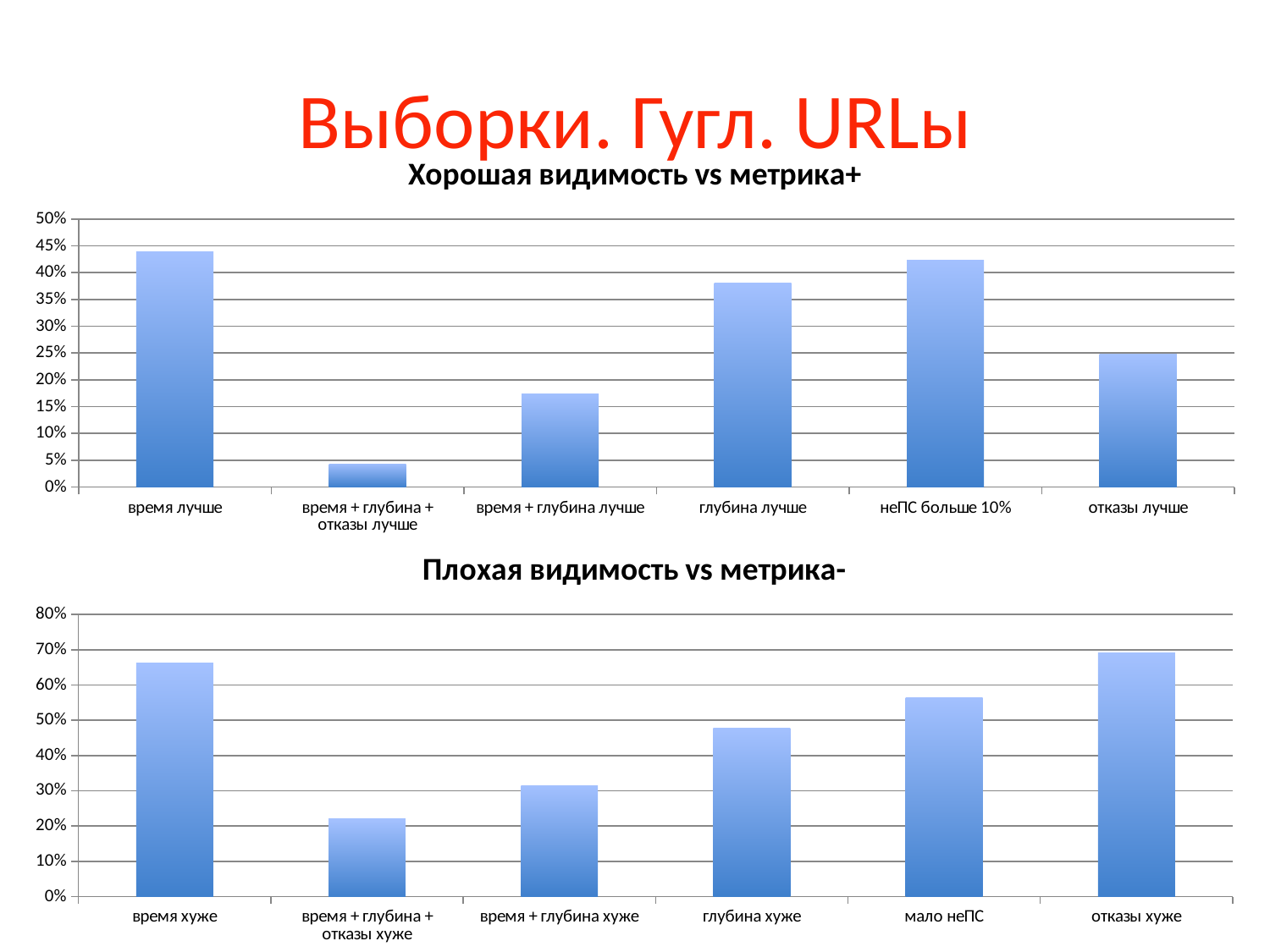
How many categories are shown on the bottom chart "Плохая видимость vs метрика-"? 6 What kind of chart is the top chart titled "Хорошая видимость vs метрика+"? bar chart On the bottom chart "Плохая видимость vs метрика-", which category has the lowest value? время + глубина + отказы хуже How many categories are shown on the top chart "Хорошая видимость vs метрика+"? 6 What is the title of the bottom chart on the slide? Плохая видимость vs метрика- On the top chart "Хорошая видимость vs метрика+", which is larger: "глубина лучше" or "отказы лучше"? глубина лучше On the bottom chart "Плохая видимость vs метрика-", is the value for "время + глубина хуже" greater or less than 40%? less On the top chart "Хорошая видимость vs метрика+", is the value for "отказы лучше" greater or less than 30%? less On the bottom chart "Плохая видимость vs метрика-", which is larger: "время хуже" or "глубина хуже"? время хуже On the top chart "Хорошая видимость vs метрика+", which category has the lowest value? время + глубина + отказы лучше On the top chart "Хорошая видимость vs метрика+", is the value for "время лучше" greater or less than 40%? greater